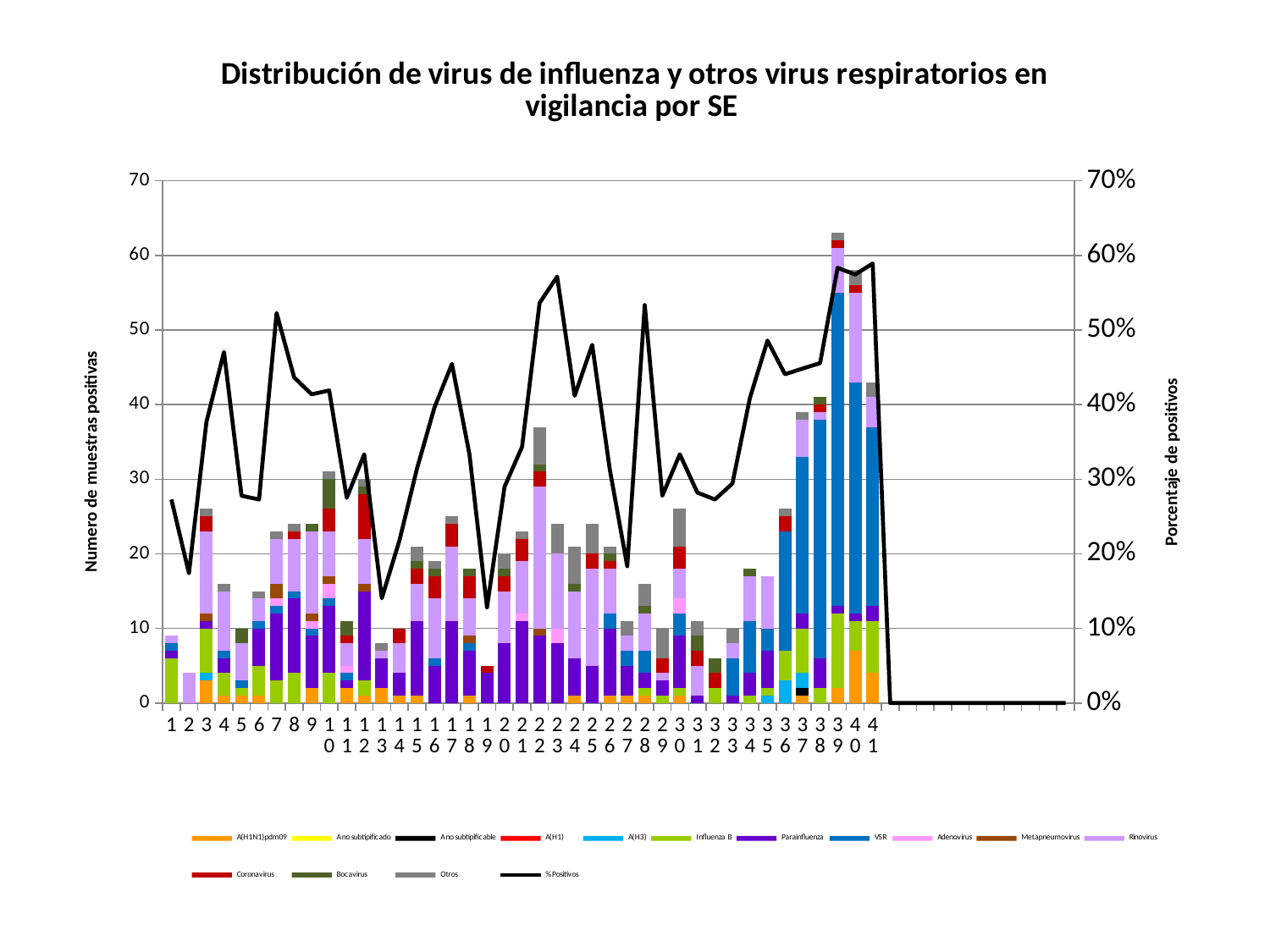
Is the % Positivos value for week 19 greater or less than 20%? less Is the total number of positive samples for week 39 greater or less than 50? greater How many series does the legend list? 15 What is the title of the chart? Distribución de virus de influenza y otros virus respiratorios en vigilancia por SE Which has the taller stacked bar, week 22 or week 23? Week 22 What is the label of the right-hand vertical axis? Porcentaje de positivos Is the total number of positive samples for week 22 greater or less than 30? greater Which week has the tallest stacked bar? 39 What kind of chart is shown on the slide? A stacked bar chart with a line